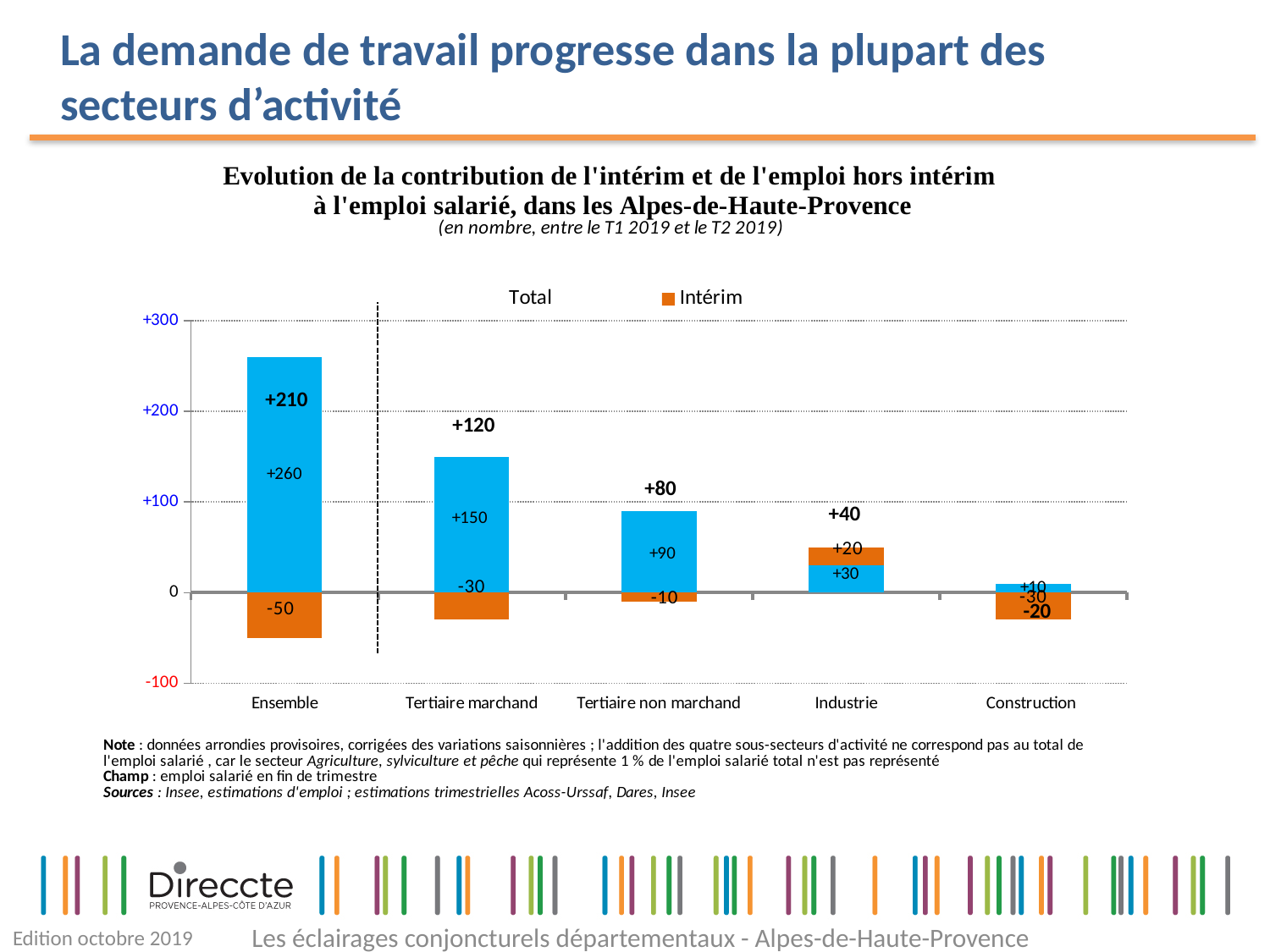
Which is larger, the Intérim value for Industrie or the Intérim value for Construction? Industrie What is the total (bold label) for Construction? -20 What is the Intérim value for Ensemble? -50 How many sectors (categories) are shown on the x axis of the chart? 5 What is the total (bold label) for Tertiaire marchand? +120 What kind of chart is shown on the slide? bar chart What colour are the Intérim bars in the chart? orange What is the difference between the total for Ensemble (+210) and the total for Tertiaire marchand (+120)? 90 What value is printed inside the blue bar for Tertiaire non marchand? +90 What is the Intérim value for Industrie? +20 Which category has the lowest total? Construction Which category has the highest total? Ensemble